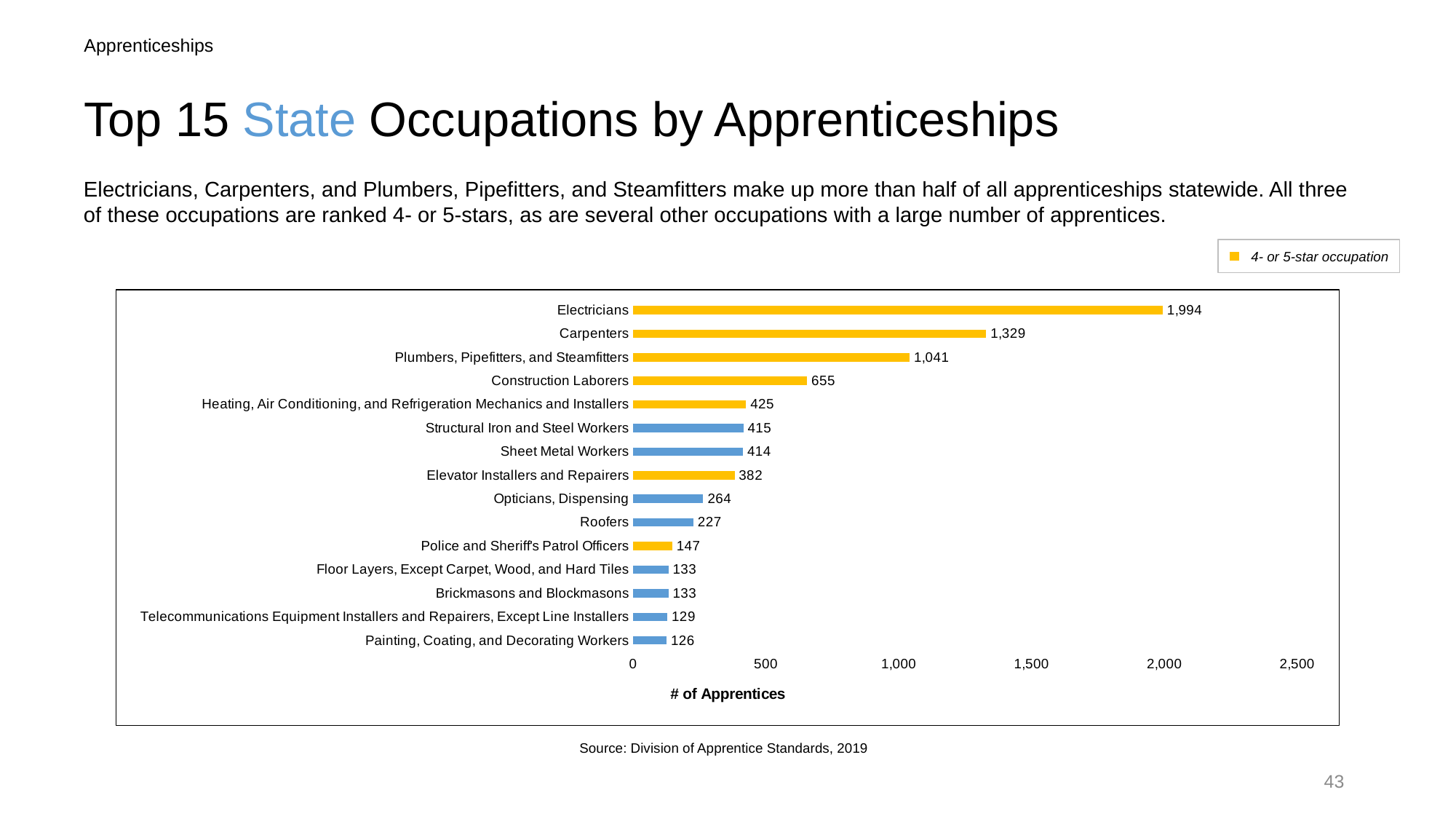
How many apprentices are shown for Roofers? 227 What is the number of apprentices for Construction Laborers? 655 Which occupation has the lowest number of apprentices? Painting, Coating, and Decorating Workers What is the label of the horizontal axis? # of Apprentices Which has more apprentices, Sheet Metal Workers or Opticians, Dispensing? Sheet Metal Workers What is the difference in apprentices between Electricians and Carpenters? 665 How many occupations are shown in the chart? 15 How many apprentices are shown for Electricians? 1,994 What kind of chart is shown on the slide? bar chart What does the yellow bar colour indicate according to the legend? 4- or 5-star occupation Which occupation has the highest number of apprentices? Electricians Is the value for Plumbers, Pipefitters, and Steamfitters greater or less than 1,000? greater